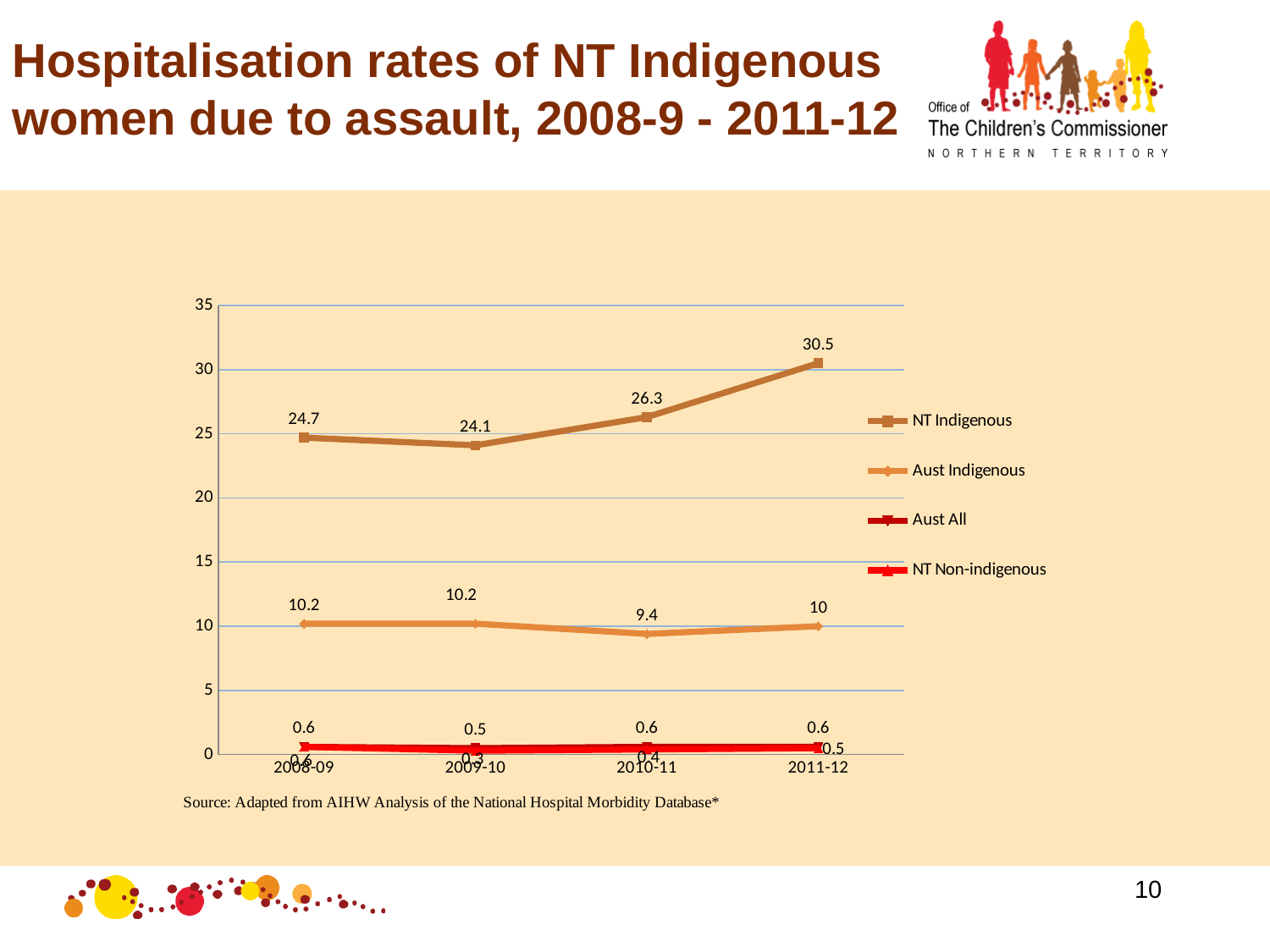
What kind of chart is shown on the slide? line chart What is the value for NT Indigenous in 2011-12? 30.5 How many series does the legend list? 4 Which is larger in 2010-11, NT Indigenous or Aust Indigenous? NT Indigenous In which year is the NT Indigenous rate lowest? 2009-10 What is the value for NT Indigenous in 2008-09? 24.7 In which year is the NT Indigenous rate highest? 2011-12 Does the NT Indigenous rate rise or fall between 2009-10 and 2011-12? rise How many time periods are shown on the x axis? 4 What is the difference between the NT Indigenous values for 2011-12 and 2008-09? 5.8 Is the value for NT Indigenous in 2011-12 greater or less than 30? greater What is the value for Aust Indigenous in 2010-11? 9.4